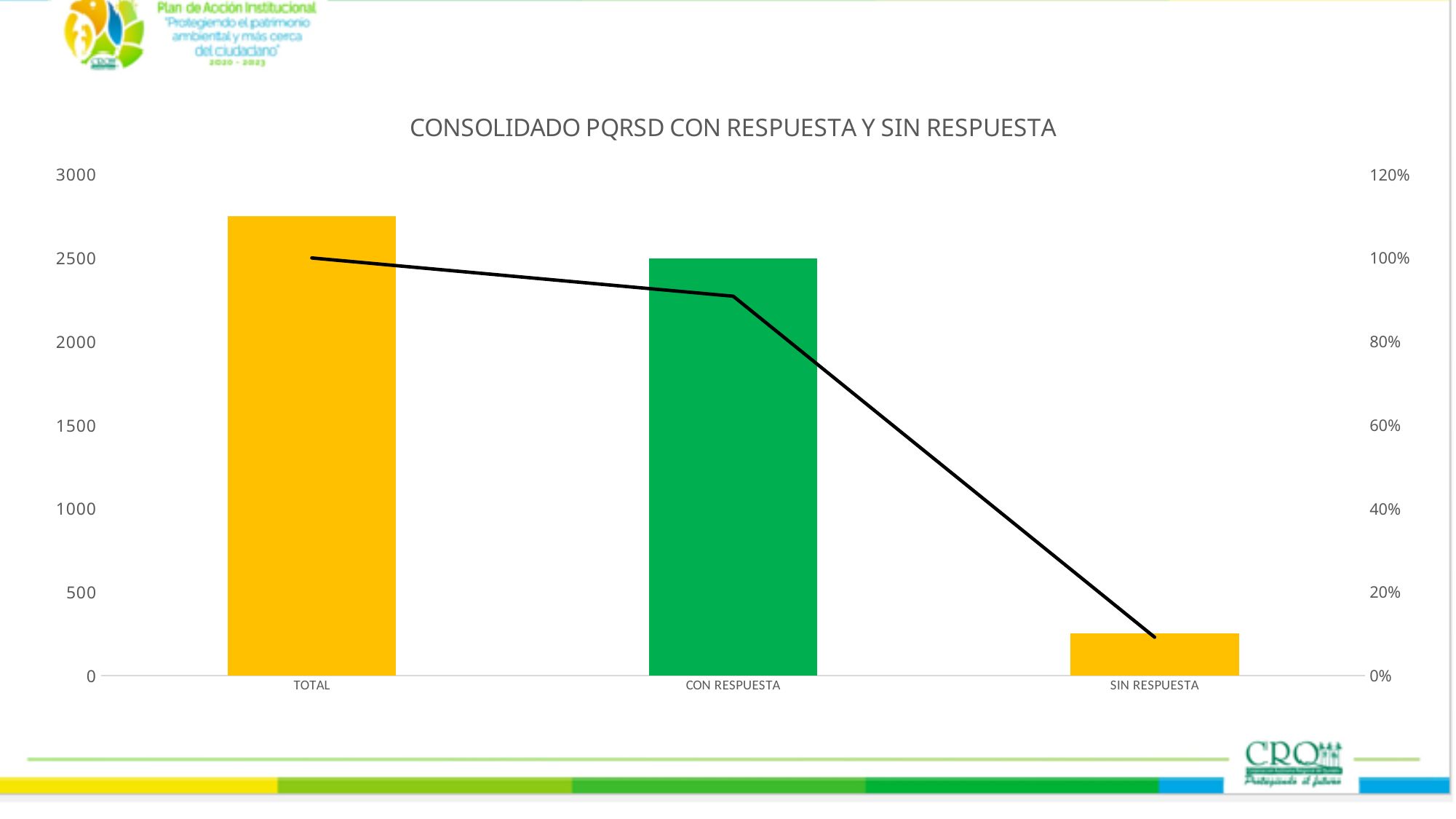
Which category has the tallest bar? TOTAL How many categories are shown on the x axis? 3 What kind of chart is shown on the slide? A bar chart combined with a line Is the bar value for TOTAL greater or less than 2500? greater Is the line value for SIN RESPUESTA on the right-hand percentage axis greater or less than 20%? less Which bar is taller, CON RESPUESTA or SIN RESPUESTA? CON RESPUESTA What is the title of the chart? CONSOLIDADO PQRSD CON RESPUESTA Y SIN RESPUESTA Is the line value for TOTAL on the right-hand percentage axis greater or less than 80%? greater Do the bar values rise or fall from left to right across the categories? fall Which category has the shortest bar? SIN RESPUESTA What colour is the CON RESPUESTA bar? Green